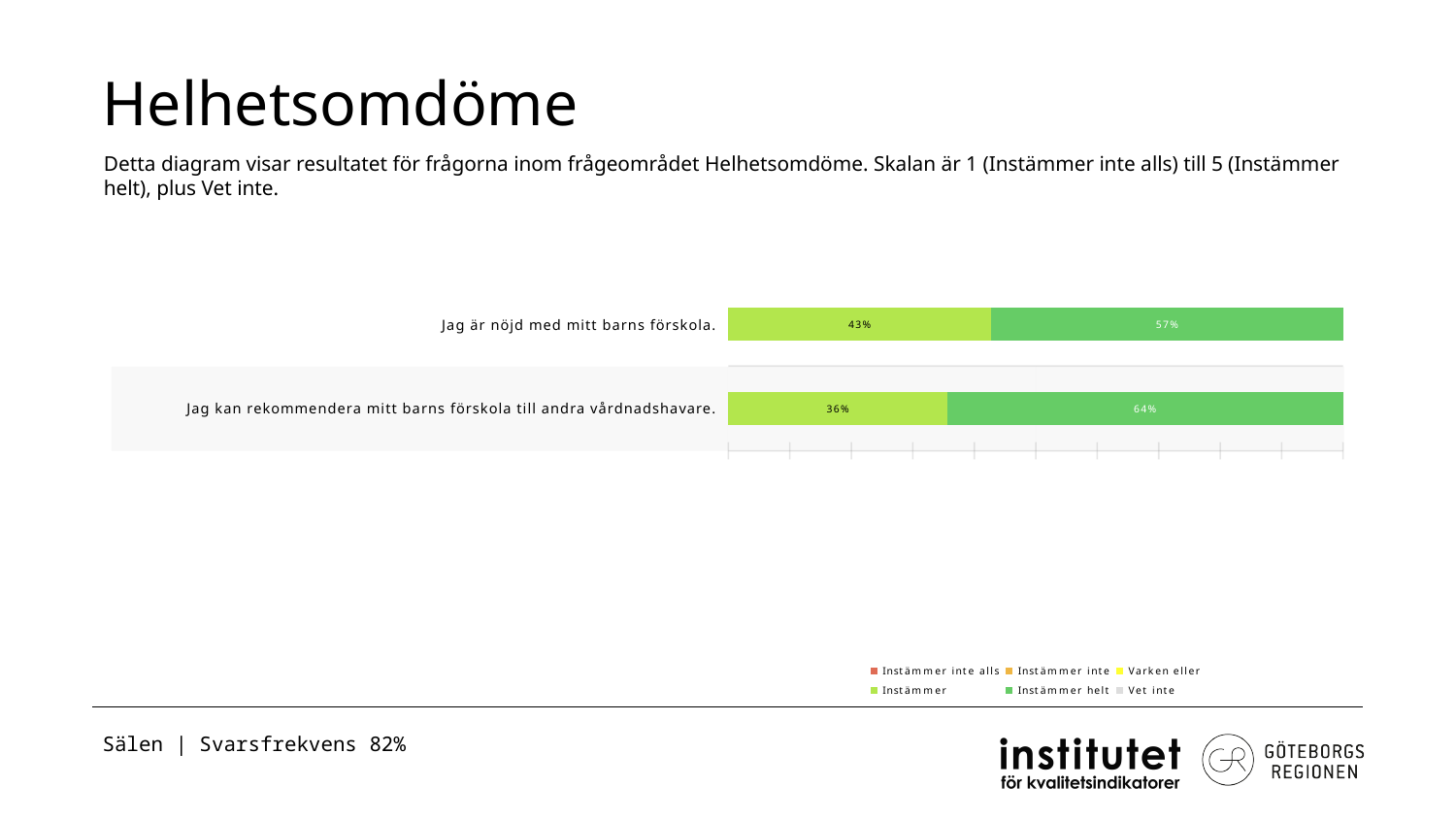
How many series does the legend list? 6 Which statement has the lower "Instämmer" share? Jag kan rekommendera mitt barns förskola till andra vårdnadshavare. What is the "Instämmer" value for "Jag är nöjd med mitt barns förskola."? 43% How many statements (categories) are plotted in the chart? 2 What kind of chart is shown on the slide? Stacked bar chart What is the "Instämmer" value for "Jag kan rekommendera mitt barns förskola till andra vårdnadshavare."? 36% What is the "Instämmer helt" value for "Jag är nöjd med mitt barns förskola."? 57% What is the "Instämmer helt" value for "Jag kan rekommendera mitt barns förskola till andra vårdnadshavare."? 64% What is the total of the labelled segments in the bar for "Jag kan rekommendera mitt barns förskola till andra vårdnadshavare."? 100% For "Jag är nöjd med mitt barns förskola.", which is larger: "Instämmer" or "Instämmer helt"? Instämmer helt Which statement has the higher "Instämmer helt" share? Jag kan rekommendera mitt barns förskola till andra vårdnadshavare. What is the difference between the "Instämmer helt" values of the two statements? 7%